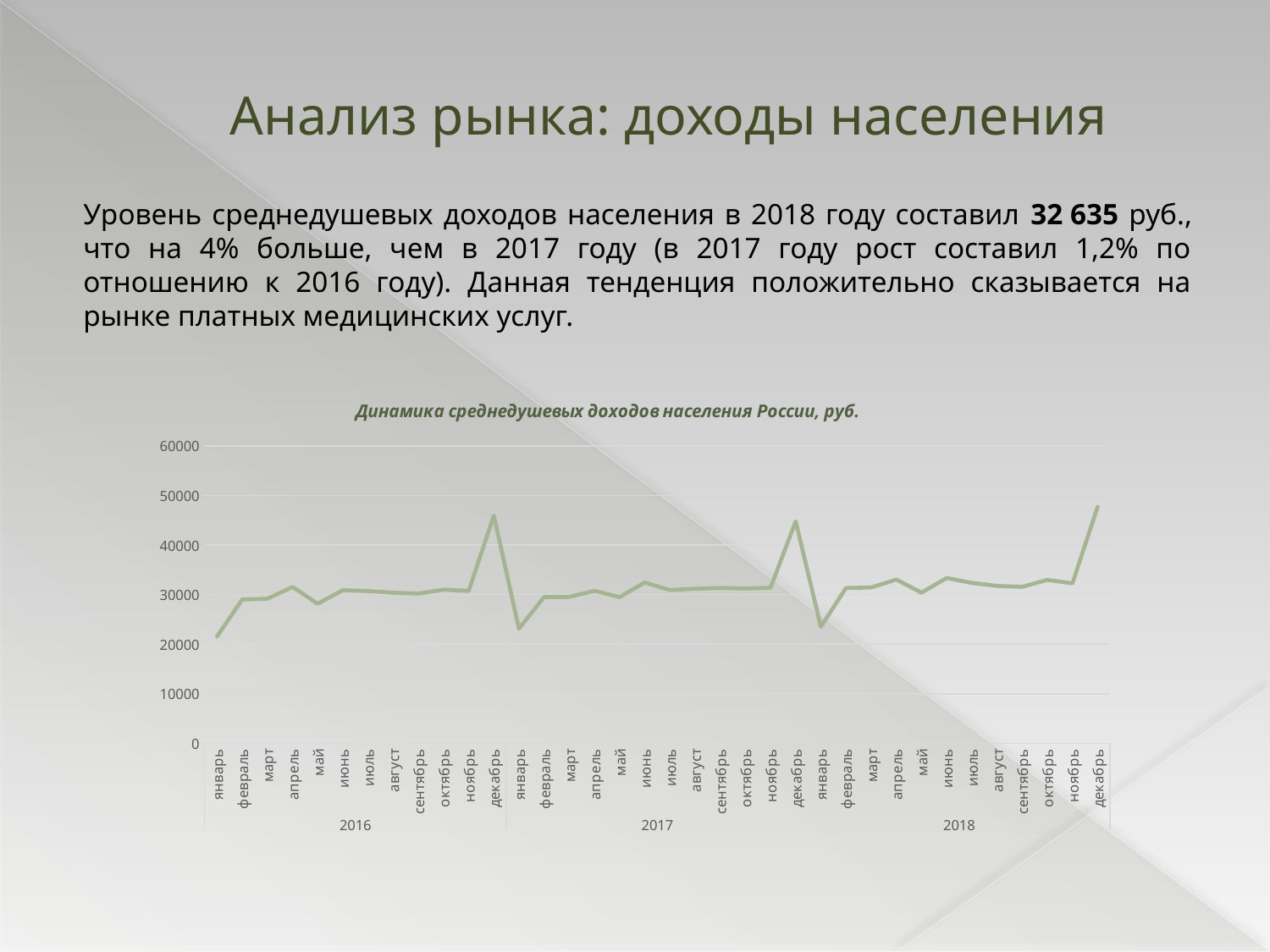
What is the title of the chart? Динамика среднедушевых доходов населения России, руб. What kind of chart is shown on the slide? line chart Which is larger, the value for декабрь 2016 or the value for январь 2017? декабрь 2016 In which month of each year does the line reach its peak? декабрь Which is larger, the value for декабрь 2018 or the value for ноябрь 2018? декабрь 2018 How many monthly data points are plotted on the chart? 36 Is the value for декабрь 2017 greater or less than 40000? greater Is the value for декабрь 2016 greater or less than 40000? greater Is the value for декабрь 2018 greater or less than 50000? less Which years are shown along the x axis of the chart? 2016, 2017, 2018